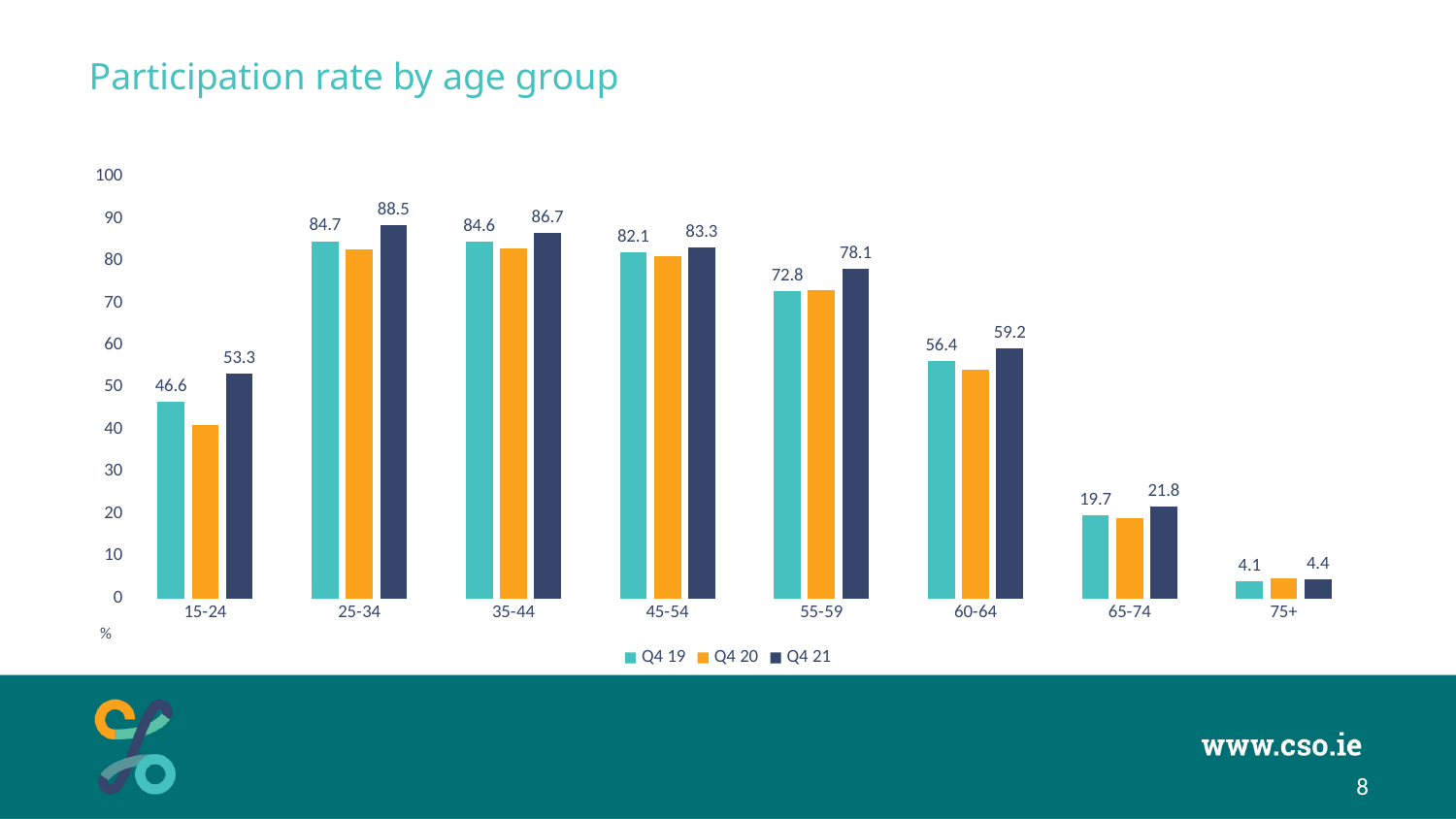
Which age group has the highest Q4 21 participation rate? 25-34 What is the title of the chart? Participation rate by age group Is the Q4 20 participation rate for the 15-24 age group greater or less than 50? less Which age group has the lowest Q4 19 participation rate? 75+ How many age groups are shown on the x axis? 8 What is the Q4 19 participation rate for the 15-24 age group? 46.6 How many series does the legend list? 3 Which is larger for the 55-59 age group: the Q4 19 rate or the Q4 21 rate? Q4 21 What kind of chart is shown on the slide? bar chart What is the Q4 21 participation rate for the 60-64 age group? 59.2 What is the Q4 21 participation rate for the 25-34 age group? 88.5 What is the difference between the Q4 21 and Q4 19 participation rates for the 15-24 age group? 6.7